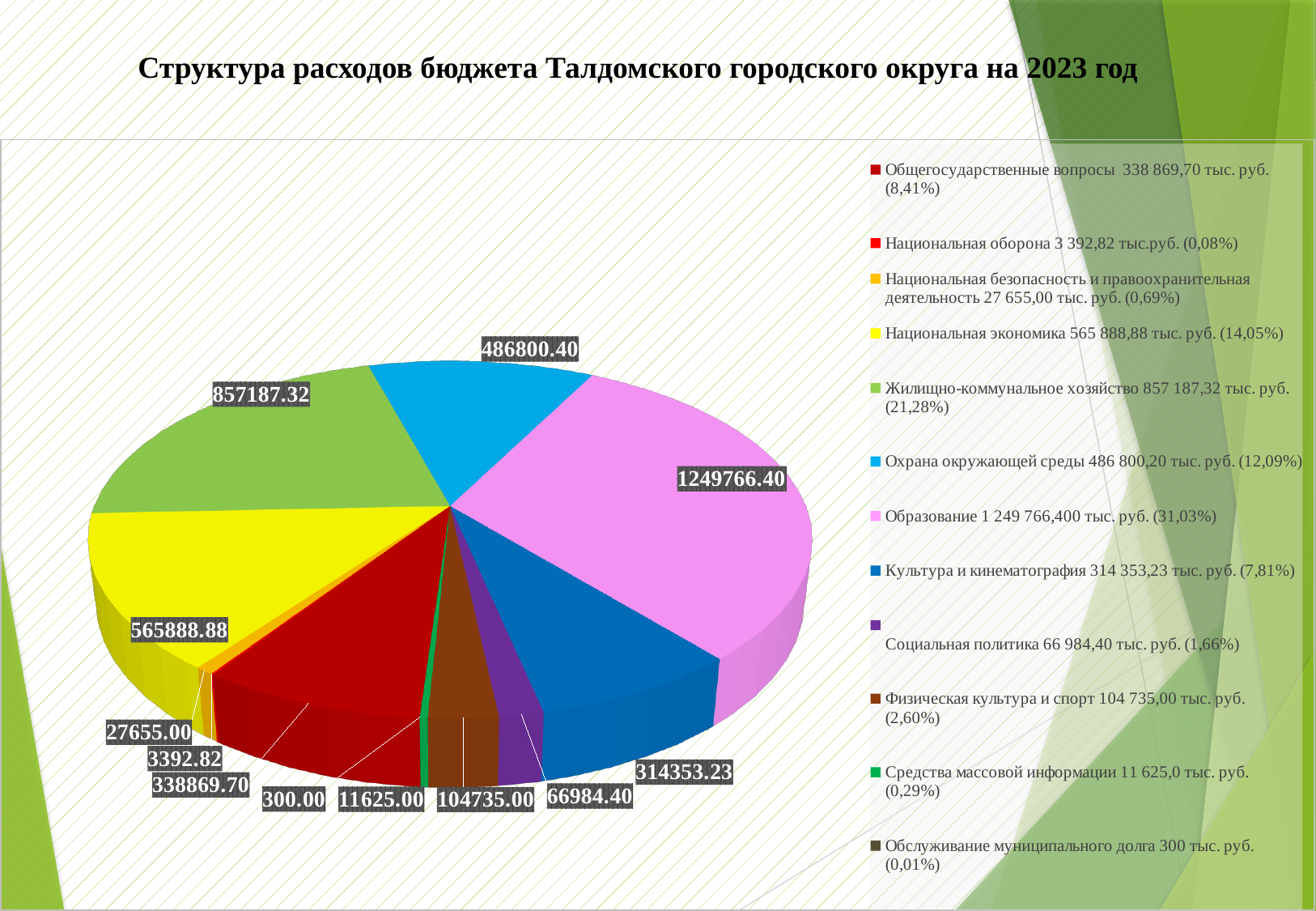
Which category has the smallest slice of the pie? Обслуживание муниципального долга What is the difference between the data label values for Жилищно-коммунальное хозяйство (857187.32) and Национальная экономика (565888.88)? 291298.44 What share of the pie does Образование account for, according to the legend? 31,03% Which category has the largest slice of the pie? Образование What kind of chart is shown on the slide? pie chart What is the title of the chart? Структура расходов бюджета Талдомского городского округа на 2023 год What share of the pie does Жилищно-коммунальное хозяйство account for, according to the legend? 21,28% How many entries does the legend list? 12 How many slices does the pie chart have? 12 Which is larger: the slice for Национальная экономика or the slice for Охрана окружающей среды? Национальная экономика What is the data label value for the Культура и кинематография slice? 314353.23 What is the data label value for the Образование slice? 1249766.40